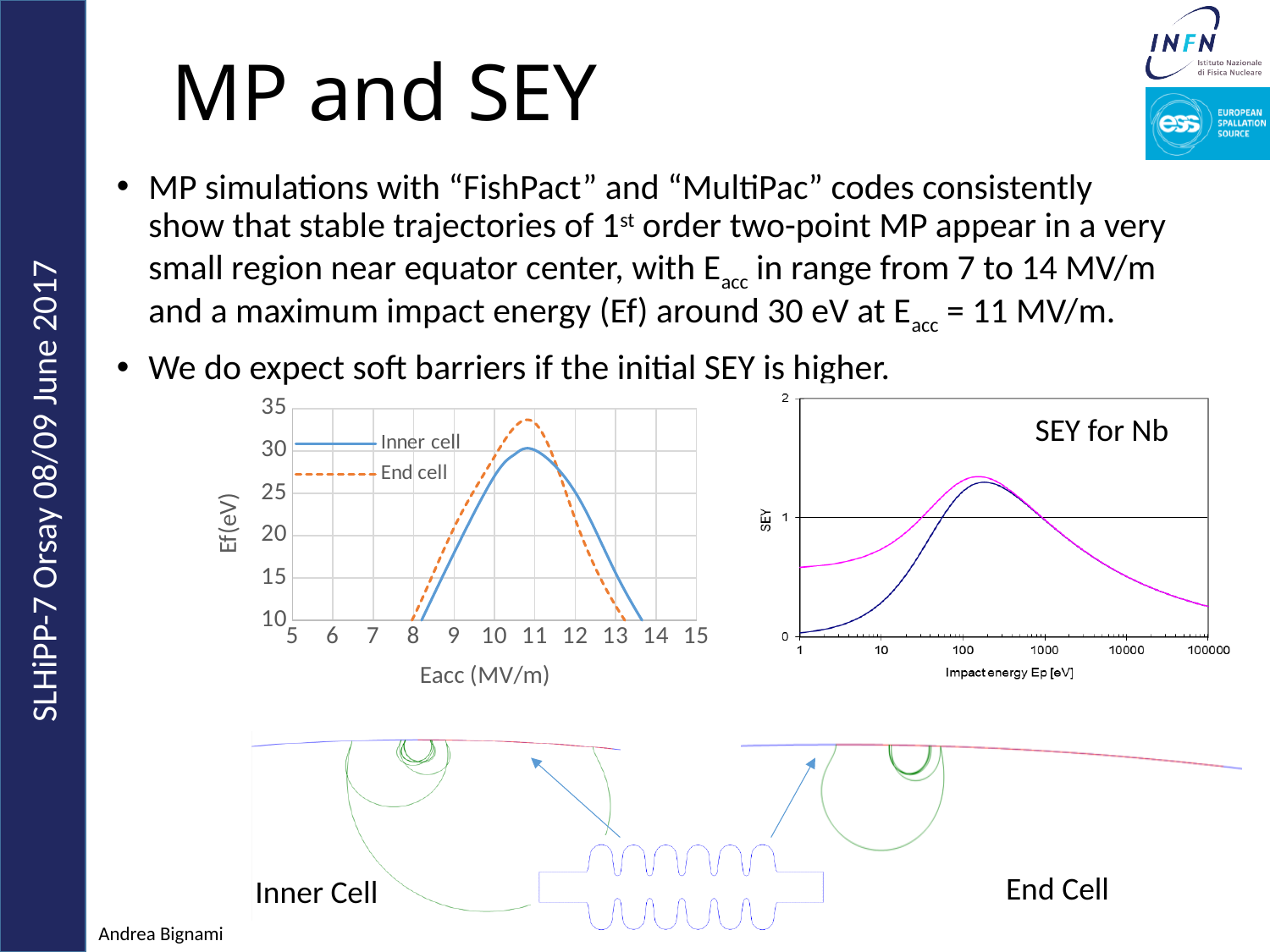
In the left chart (Ef vs Eacc), is the Inner cell value at Eacc = 9 MV/m greater or less than 20? less How many series does the legend of the left chart (Ef vs Eacc) list? 2 What kind of chart is the left chart with Ef(eV) on the y axis? line chart In the left chart (Ef vs Eacc), at Eacc = 9 MV/m, which series has the higher Ef, Inner cell or End cell? End cell In the right chart (SEY for Nb), is the peak SEY value greater or less than 1? greater What is the x-axis label of the left chart? Eacc (MV/m) In the right chart (SEY for Nb), is the SEY at an impact energy of 10000 eV greater or less than 1? less In the left chart (Ef vs Eacc), at Eacc = 13 MV/m, which series has the higher Ef, Inner cell or End cell? Inner cell In the left chart (Ef vs Eacc), which series reaches the higher peak value of Ef? End cell What is the title of the right chart? SEY for Nb In the left chart (Ef vs Eacc), which series is drawn with a dashed line? End cell